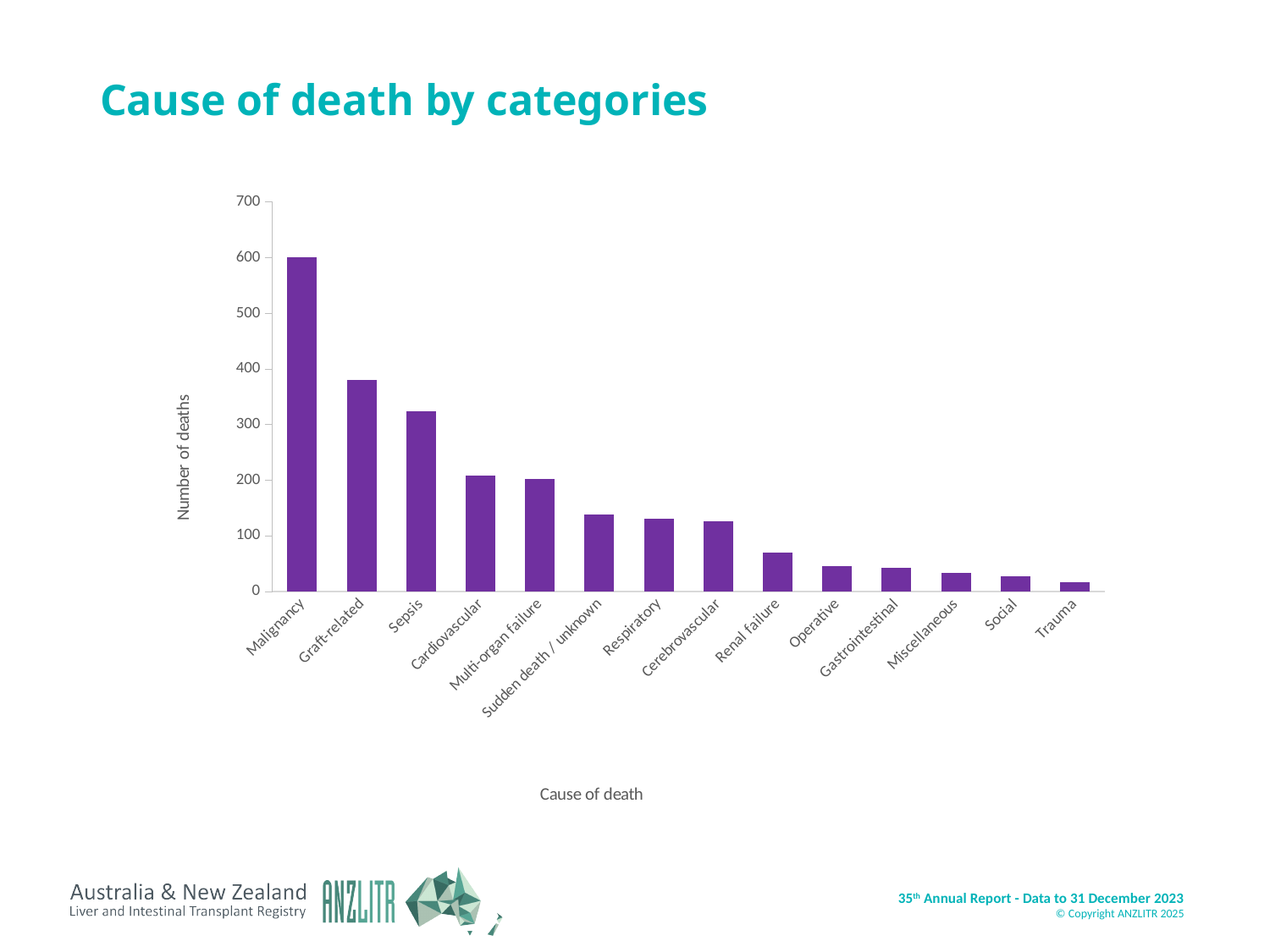
What is the label on the vertical axis of the chart? Number of deaths Is the value for Renal failure greater or less than 100? less Is the value for Sudden death / unknown greater or less than 100? greater Is the value for Graft-related greater or less than 300? greater Which cause of death has the highest number of deaths? Malignancy Which has more deaths, Renal failure or Respiratory? Respiratory What type of chart is shown on the slide? Bar chart How many cause-of-death categories are shown on the x axis? 14 Do the bar values rise or fall moving from left to right along the x axis? Fall Which cause of death has the lowest number of deaths? Trauma Which has more deaths, Graft-related or Sepsis? Graft-related